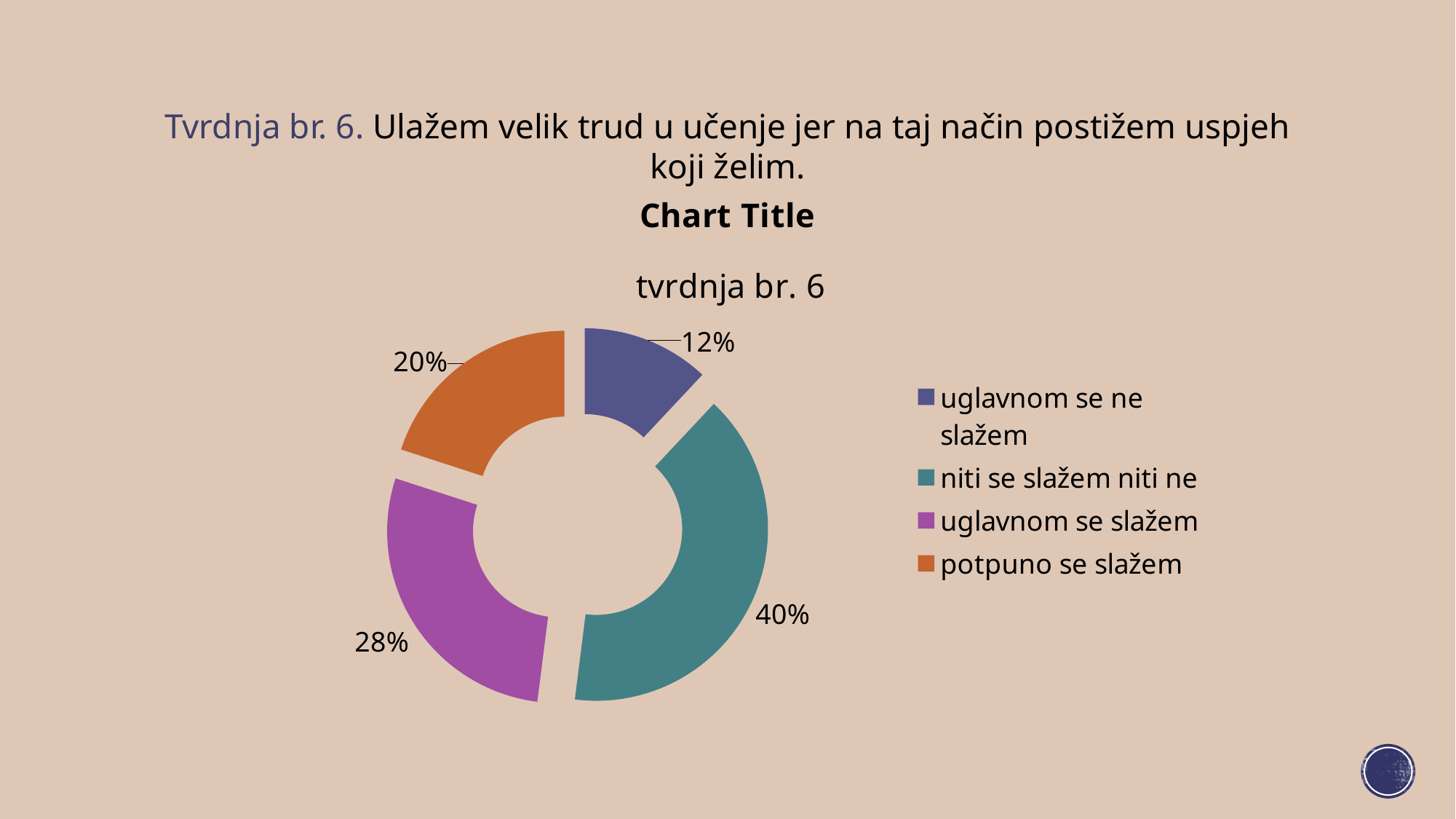
Which has a larger share: 'potpuno se slažem' or 'uglavnom se slažem'? uglavnom se slažem What kind of chart is shown on the slide? Doughnut chart Which response category has the smallest share? uglavnom se ne slažem Which response category has the largest share? niti se slažem niti ne What percentage of responses are 'uglavnom se slažem'? 28% How many categories does the chart show? 4 What percentage of responses are 'potpuno se slažem'? 20% What percentage of responses are 'uglavnom se ne slažem'? 12% What is the difference in percentage points between 'niti se slažem niti ne' and 'uglavnom se slažem'? 12 What is the combined share of 'uglavnom se slažem' and 'potpuno se slažem'? 48% What colour is the slice for 'potpuno se slažem'? Orange What percentage of responses are 'niti se slažem niti ne'? 40%